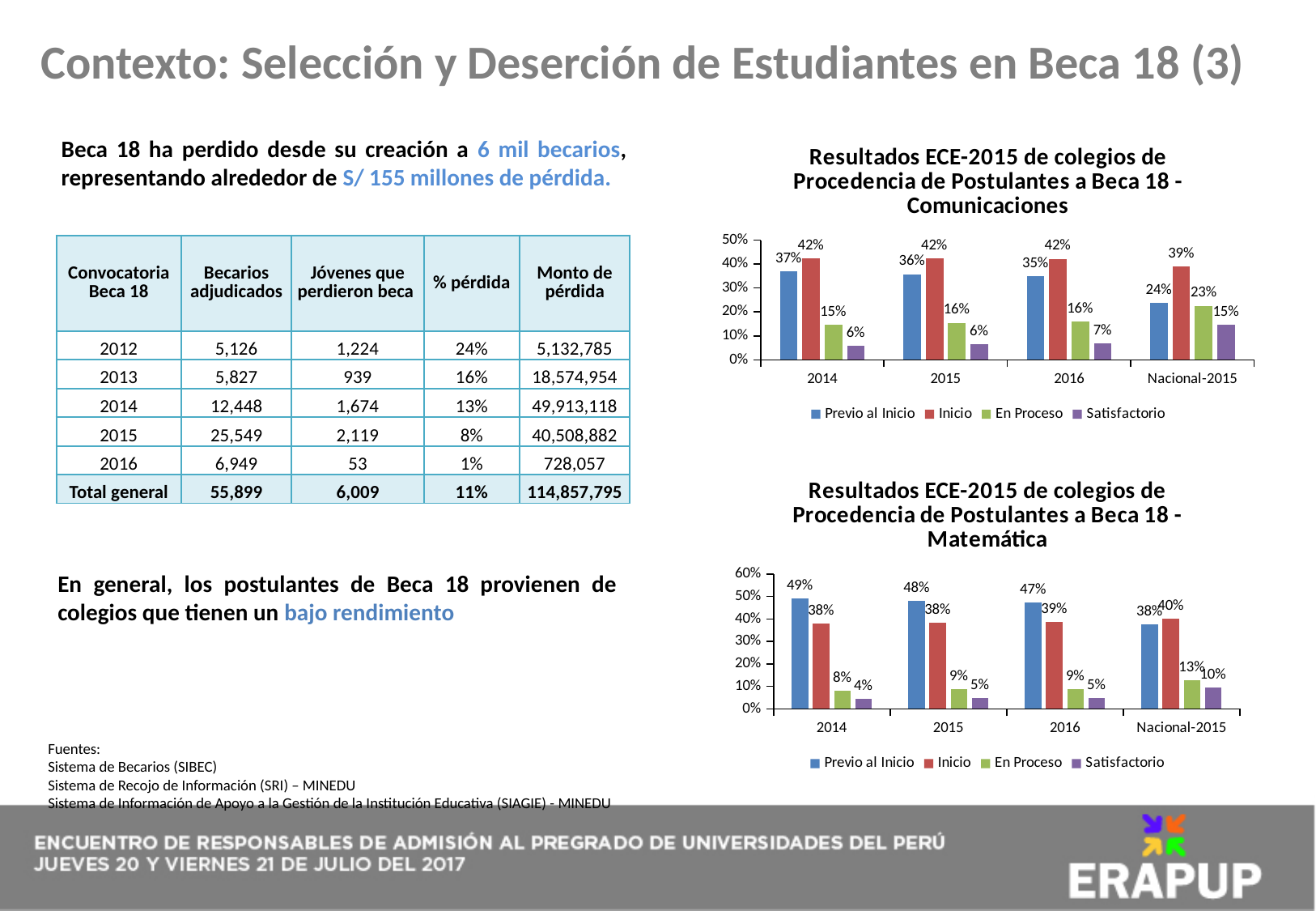
In the Matemática chart, what is the value for Previo al Inicio in 2016? 47% In the Matemática chart, which category has the highest Previo al Inicio value? 2014 In the Matemática chart, which is larger in Nacional-2015: Previo al Inicio or Inicio? Inicio In the Comunicaciones chart, which category has the lowest Satisfactorio value? 2014 and 2015 (both 6%) How many series does the legend of the Matemática chart list? 4 In the Comunicaciones chart, what is the difference between Inicio and Previo al Inicio in 2016? 7% In the Matemática chart, what is the difference between Previo al Inicio and Inicio in 2014? 11% In the Matemática chart, what is the value for En Proceso in Nacional-2015? 13% In the Comunicaciones chart, what is the value for Satisfactorio in Nacional-2015? 15% What kind of chart is the Comunicaciones chart? Bar chart How many categories are shown on the x axis of the Comunicaciones chart? 4 In the Comunicaciones chart, what is the value for Previo al Inicio in 2014? 37%